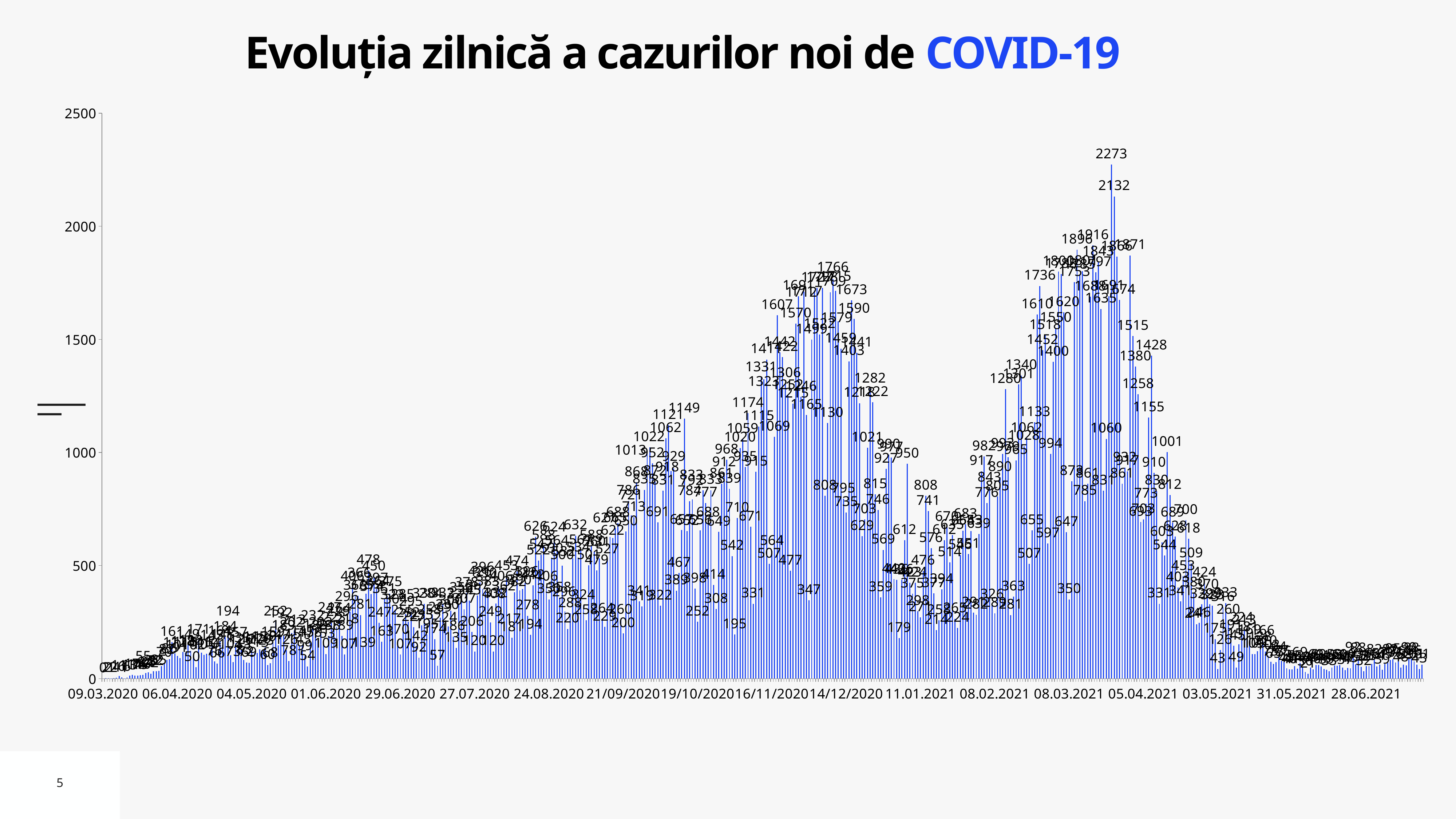
What is the difference between the two highest labelled values, 2273 and 2132? 141 What is the second highest value labelled on the chart, next to the 2273 peak? 2132 Is the highest value on the chart greater or less than 2000? greater What kind of chart is shown on the slide? bar chart What is the highest daily value labelled on the chart? 2273 What is the highest tick value shown on the vertical axis? 2500 Do the values rise or fall between 09.03.2020 and 06.04.2020? rise What is the title of the chart? Evoluția zilnică a cazurilor noi de COVID-19 Do the values rise or fall between 05.04.2021 and 31.05.2021? fall What is the highest value labelled in the wave around 14/12/2020? 1766 Are the values around 28.06.2021 greater or less than 500? less